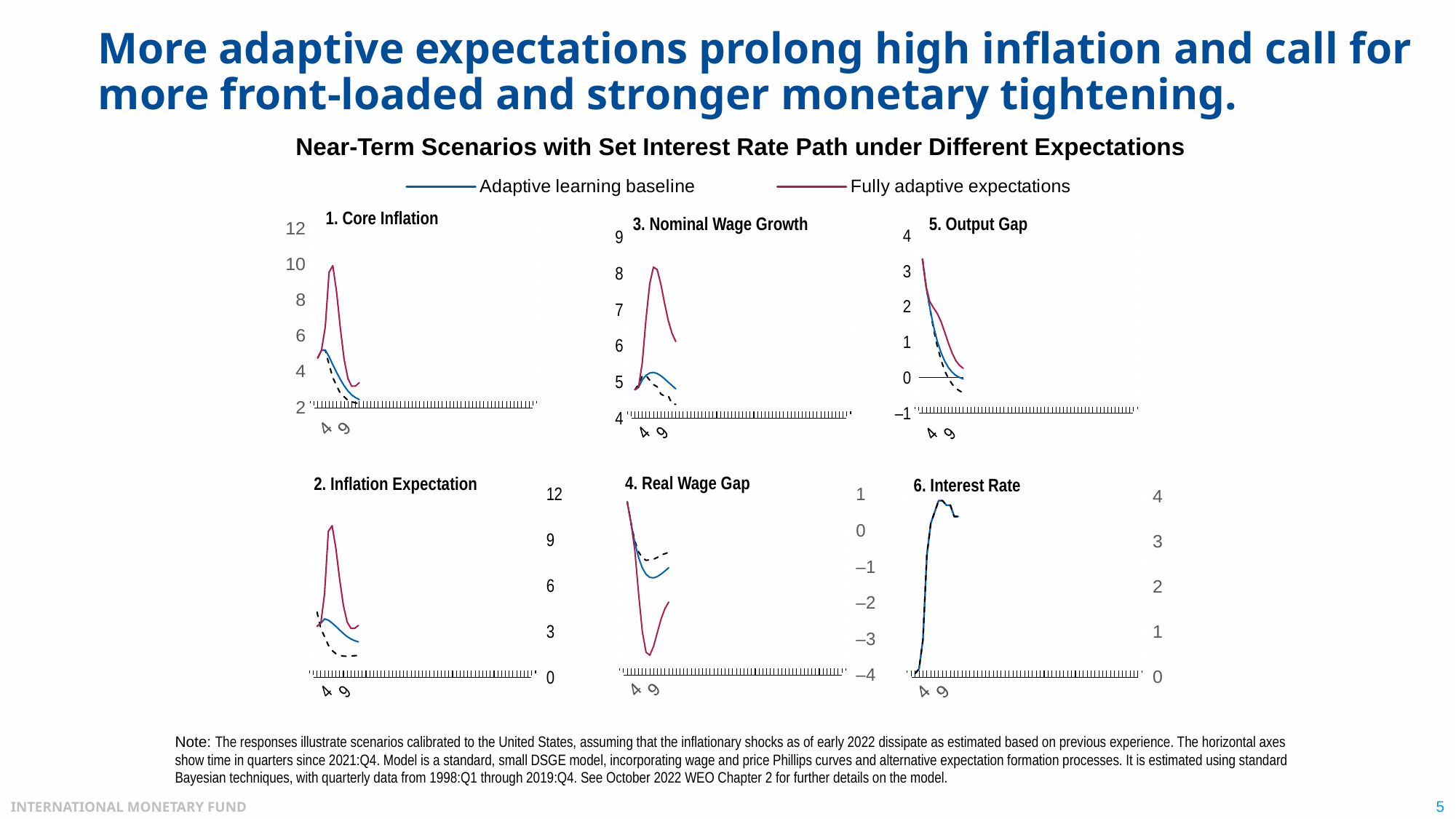
In '1. Core Inflation', which series reaches the higher peak? Fully adaptive expectations In '6. Interest Rate', is the peak value greater or less than 3? greater In '1. Core Inflation', is the peak value of the Fully adaptive expectations line greater or less than 8? greater What kind of chart is '1. Core Inflation'? line chart In '5. Output Gap', do the values rise or fall along the x axis? fall How many series does the legend list? 2 What is the overall title of the figure? Near-Term Scenarios with Set Interest Rate Path under Different Expectations In '4. Real Wage Gap', is the lowest value of the Fully adaptive expectations line greater or less than –2? less In '3. Nominal Wage Growth', which series reaches the higher peak? Fully adaptive expectations How many chart panels are shown on the slide? 6